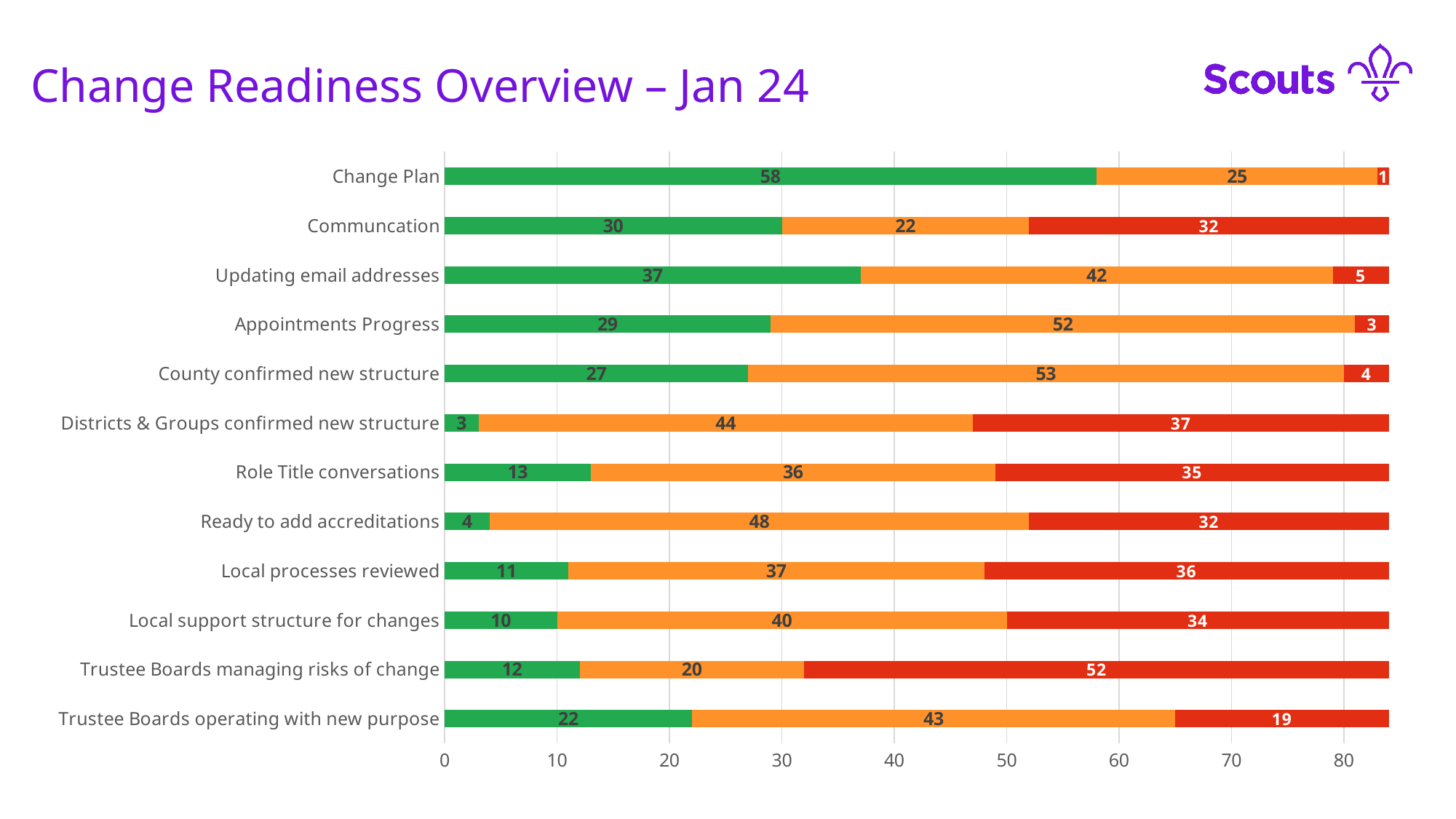
What is the total of the stacked bar for Change Plan? 84 Which has the larger orange segment, Appointments Progress or Updating email addresses? Appointments Progress What is the value of the green segment for Change Plan? 58 Which category has the smallest green segment? Districts & Groups confirmed new structure What is the value of the orange segment for County confirmed new structure? 53 What is the difference between the green segment for Change Plan and the green segment for Communcation? 28 Which category has the largest red segment? Trustee Boards managing risks of change Which category has the largest green segment? Change Plan Which category has the smallest red segment? Change Plan What kind of chart is shown on the slide? Stacked bar chart How many categories are shown on the chart? 12 What is the value of the red segment for Trustee Boards managing risks of change? 52